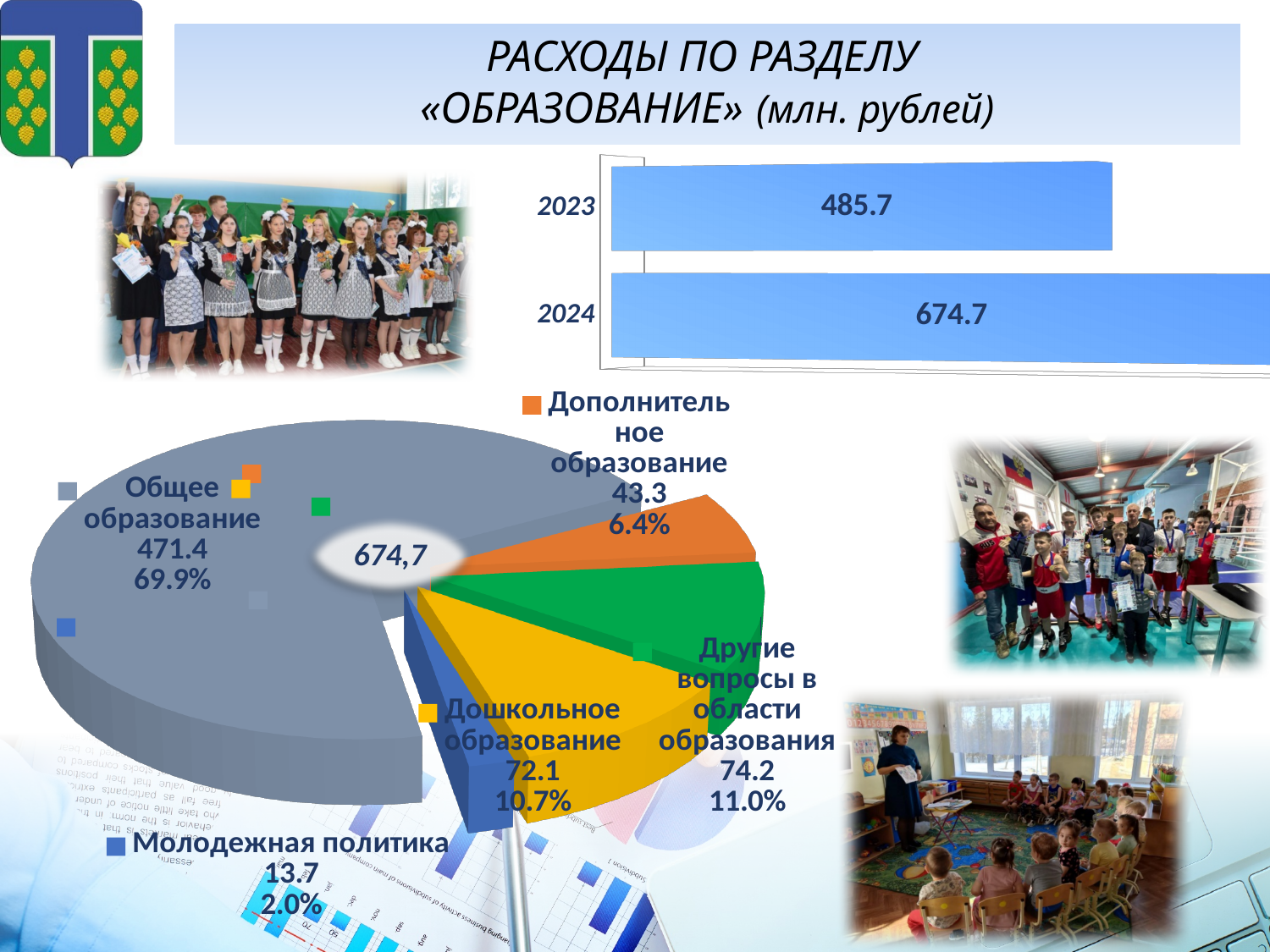
On the pie chart, what is the value for Другие вопросы в области образования? 74.2 On the pie chart, what is the difference between the values for Другие вопросы в области образования and Дошкольное образование? 2.1 On the bar chart at the top, what is the value for 2023? 485.7 On the bar chart at the top, what is the value for 2024? 674.7 On the pie chart, what share does Дошкольное образование have? 10.7% On the pie chart, which category has the largest share? Общее образование On the pie chart, what is the value for Общее образование? 471.4 On the bar chart at the top, by how much does the 2024 value exceed the 2023 value? 189.0 On the pie chart, how many categories are shown? 5 What kind of chart is the chart at the top of the slide showing 2023 and 2024? bar chart On the pie chart, which category has the smallest share? Молодежная политика On the bar chart at the top, which year has the larger value, 2023 or 2024? 2024